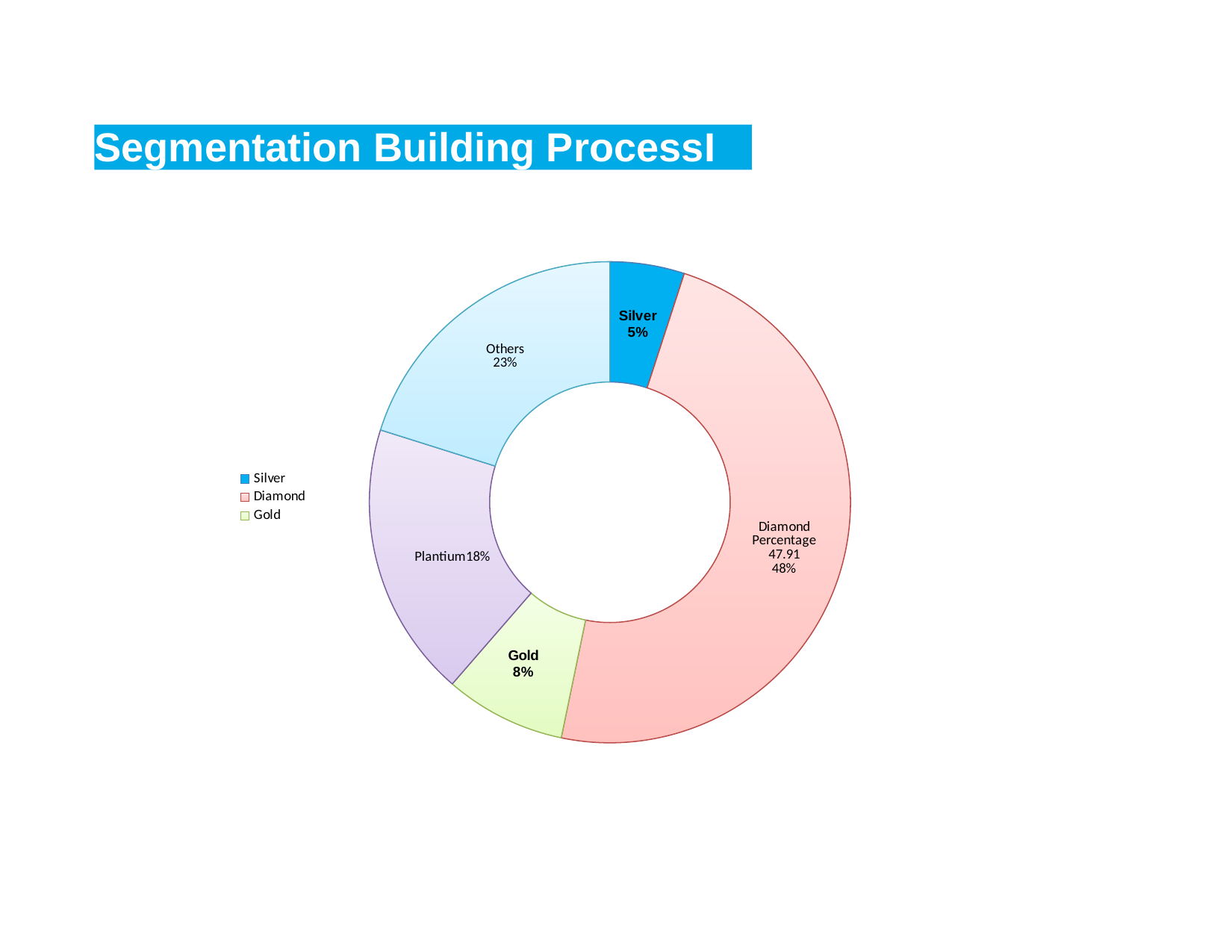
Which slice has the largest share of the doughnut? Diamond What percentage is shown for the Plantium slice? 18% How many slices does the doughnut chart have? 5 What kind of chart is shown on the slide? doughnut chart What value is printed for Diamond Percentage in the Diamond slice? 47.91 How many entries does the legend list? 3 What percentage is shown for the Silver slice? 5% Which is larger, the Others slice or the Plantium slice? Others What percentage is shown for the Others slice? 23% What percentage is shown for the Gold slice? 8% Which slice has the smallest share of the doughnut? Silver What is the difference in percentage points between the Others slice and the Gold slice? 15%